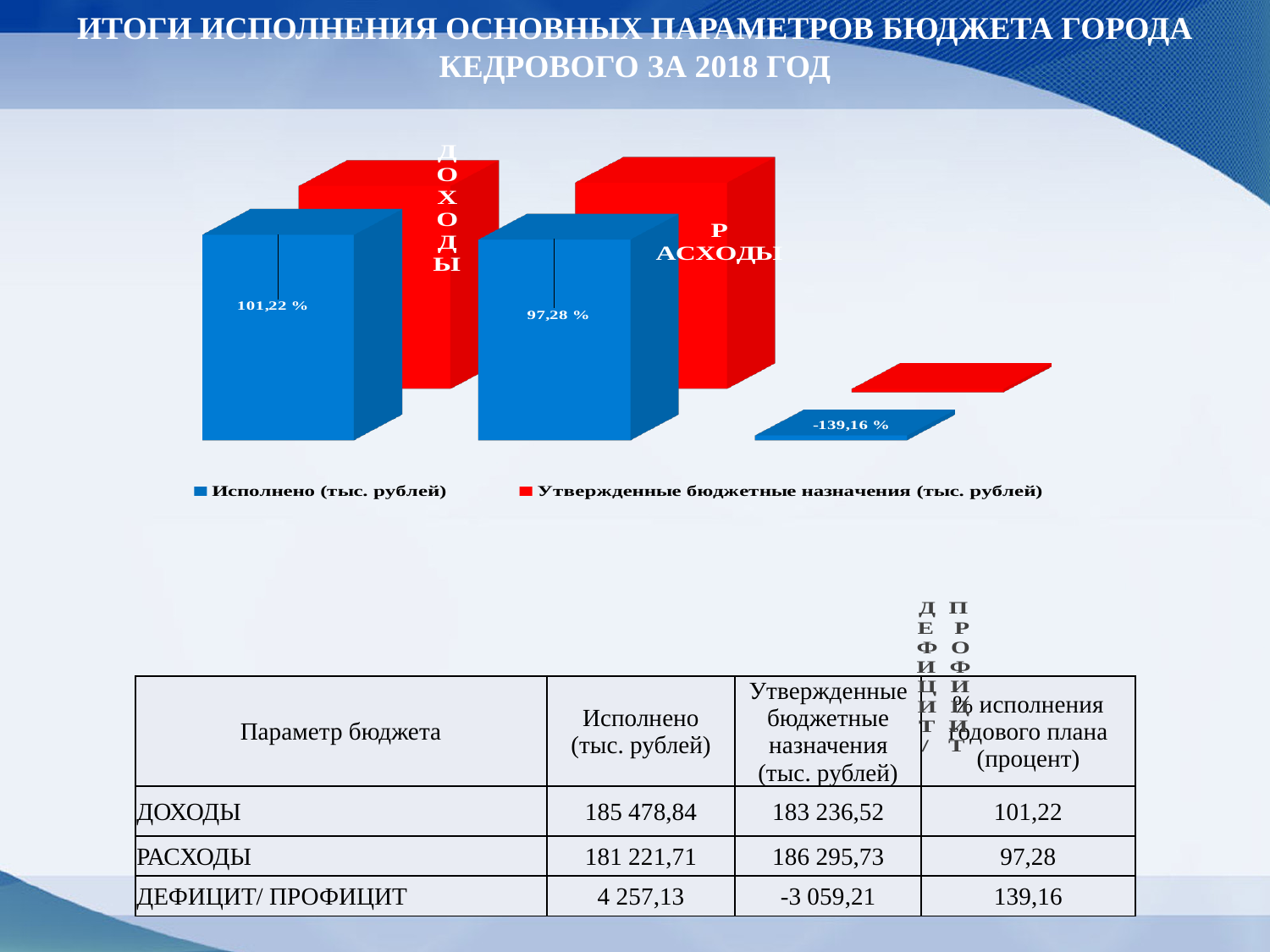
What is the name of the series shown in red in the chart legend? Утвержденные бюджетные назначения (тыс. рублей) How many categories (groups of bars) are plotted in the chart? 3 What data label is printed on the rightmost blue bar in the chart? -139,16 % Which colour represents the series Исполнено (тыс. рублей) in the chart? blue For РАСХОДЫ, which bar is taller: Исполнено or Утвержденные бюджетные назначения? Утвержденные бюджетные назначения How many series does the chart legend list? 2 Which category has the tallest Исполнено (тыс. рублей) bar? ДОХОДЫ What kind of chart is shown on the slide? bar chart What data label is printed on the blue bar for РАСХОДЫ? 97,28 % What data label is printed on the blue bar for ДОХОДЫ? 101,22 %